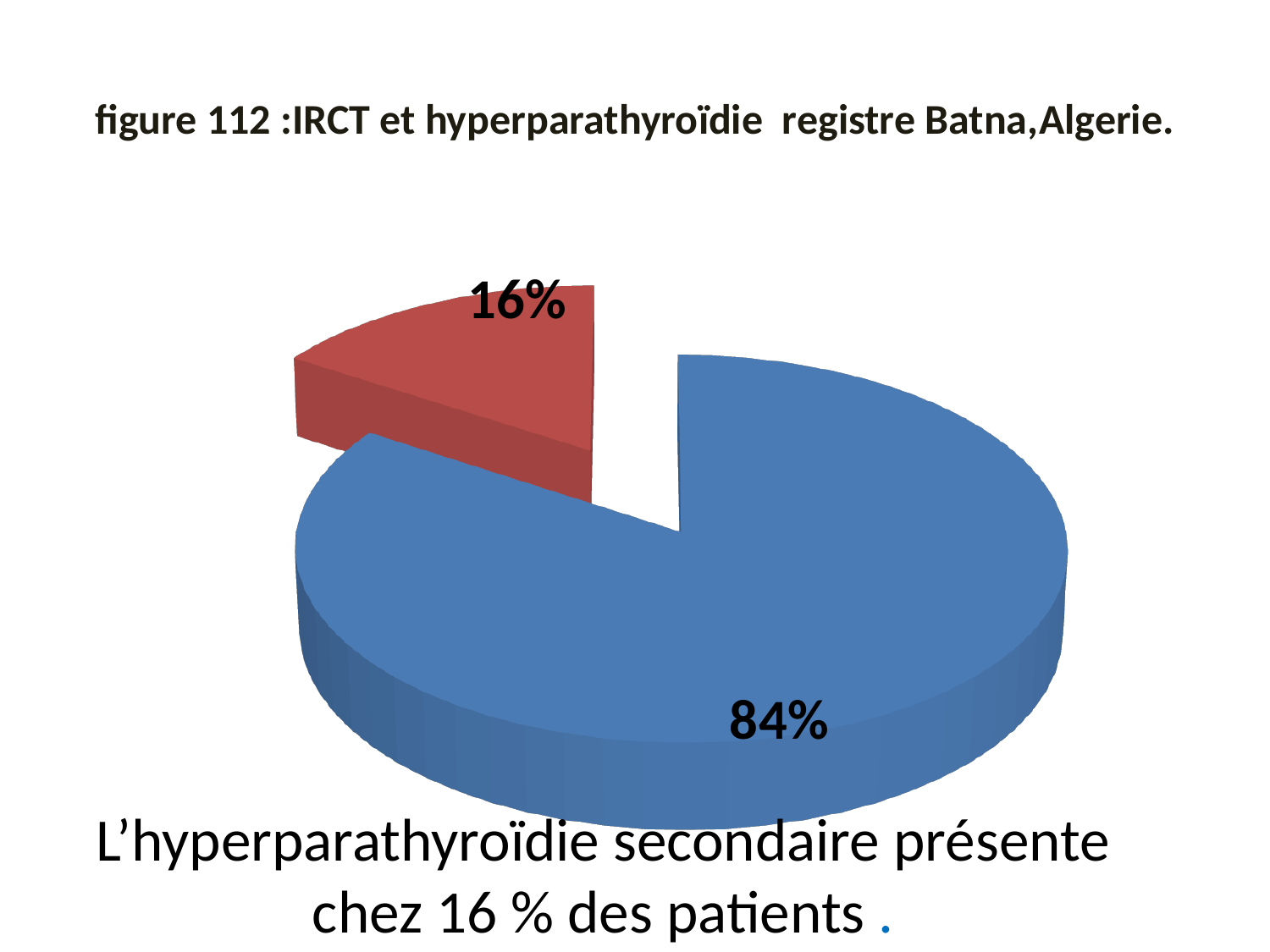
What is the figure number given in the chart title? figure 112 Which slice of the pie chart is the smallest? the red slice (16%) What do the two slice percentages add up to? 100% Which is larger, the red slice or the blue slice? the blue slice What share of the pie does the blue slice represent? 84% Which slice of the pie chart is the largest? the blue slice (84%) What kind of chart is shown on the slide? pie chart Which colour is the slice that is pulled out from the rest of the pie? red How many slices does the pie chart have? 2 What is the difference in percentage points between the blue slice and the red slice? 68 What share of the pie does the red slice represent? 16% Is the share of the red slice greater or less than 20%? less